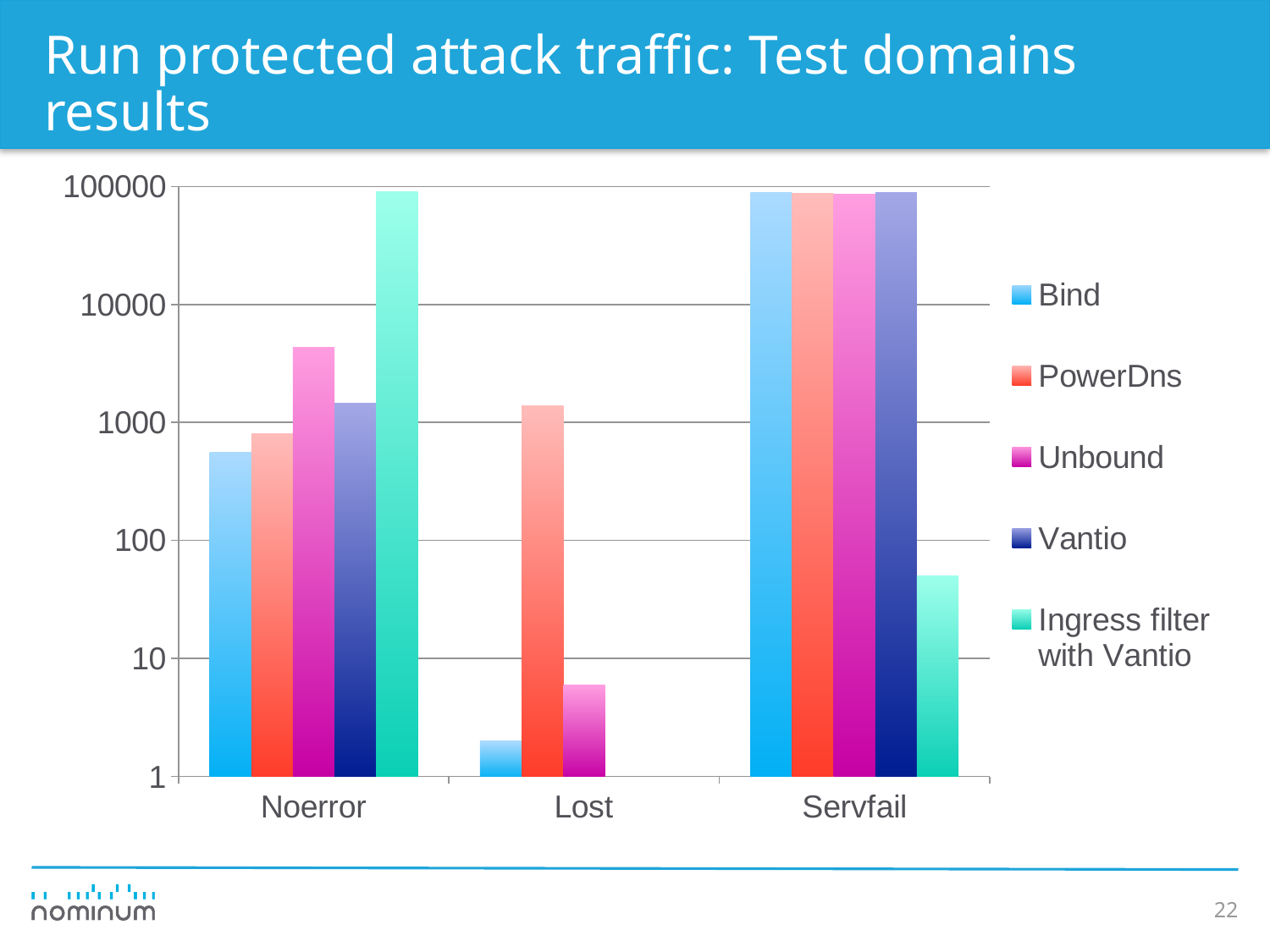
Is the Unbound value for Noerror greater or less than 1000? greater Is the PowerDns value for Lost greater or less than 1000? greater In the Lost category, which series has the highest value? PowerDns In the Noerror category, which is larger: the Unbound value or the Vantio value? Unbound What kind of chart is shown on the slide? bar chart How many series does the chart's legend list? 5 In the Noerror category, which series has the lowest value? Bind In the Servfail category, which series has the lowest value? Ingress filter with Vantio In the Noerror category, which series has the highest value? Ingress filter with Vantio What is the title of the slide containing the chart? Run protected attack traffic: Test domains results Is the Ingress filter with Vantio value for Servfail greater or less than 100? less How many categories are shown on the x axis of the chart? 3